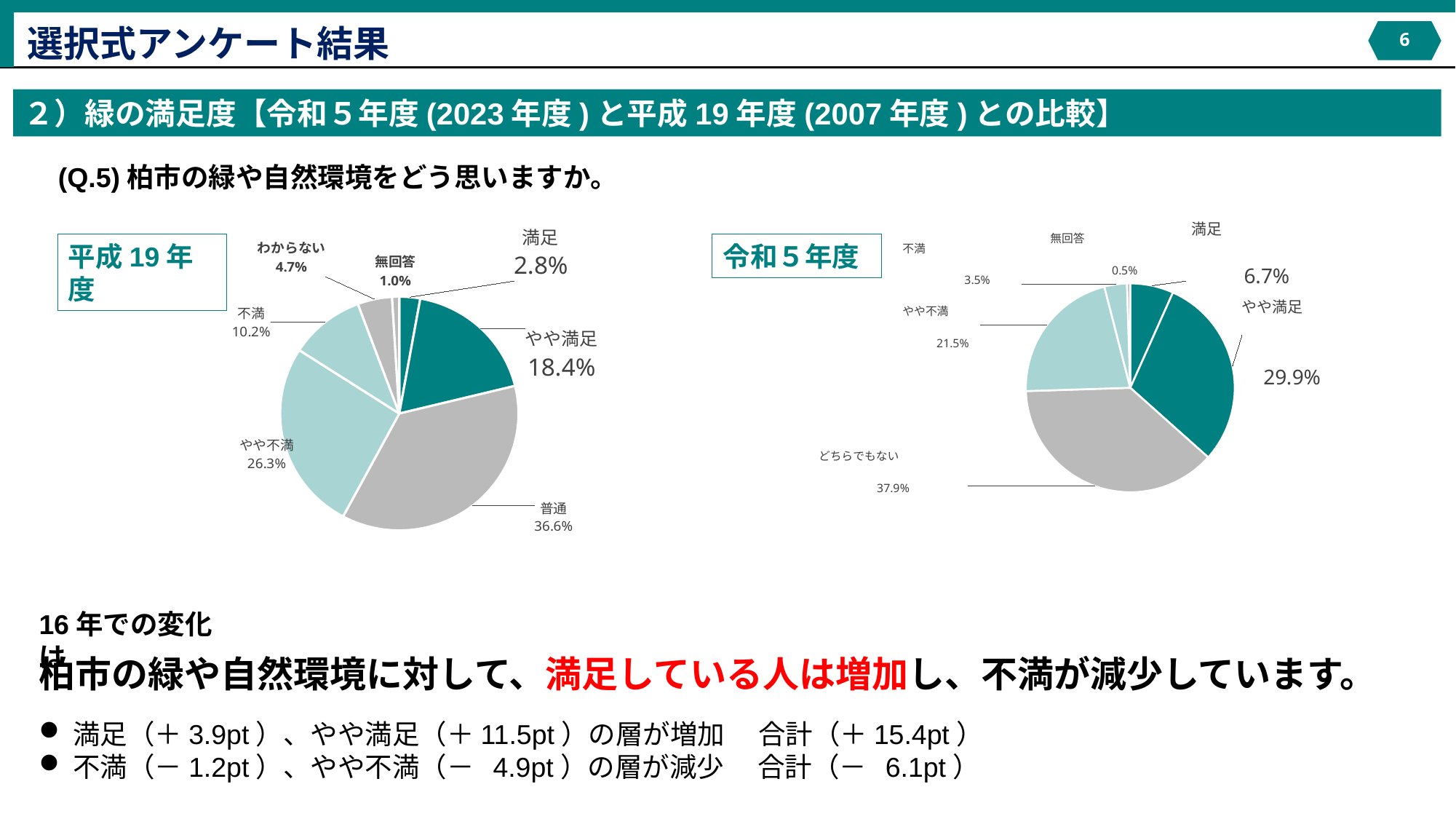
In the 令和5年度 pie chart, which category has the smallest share? 無回答 What type of chart is used for the 令和5年度 data? Pie chart In the 令和5年度 pie chart, what is the value for どちらでもない? 37.9% In the 平成19年度 pie chart, which category has the largest share? 普通 In the 令和5年度 pie chart, what share of the pie does やや満足 represent? 29.9% In the 平成19年度 pie chart, what is the value for やや満足? 18.4% Which is larger: やや不満 in the 平成19年度 chart or やや不満 in the 令和5年度 chart? 平成19年度 How many slices does the 平成19年度 pie chart have? 7 How many slices does the 令和5年度 pie chart have? 6 What is the difference between the 満足 value in the 令和5年度 chart and the 満足 value in the 平成19年度 chart? 3.9pt In the 平成19年度 pie chart, which category has the smallest share? 無回答 In the 令和5年度 pie chart, what is the value for 不満? 3.5%